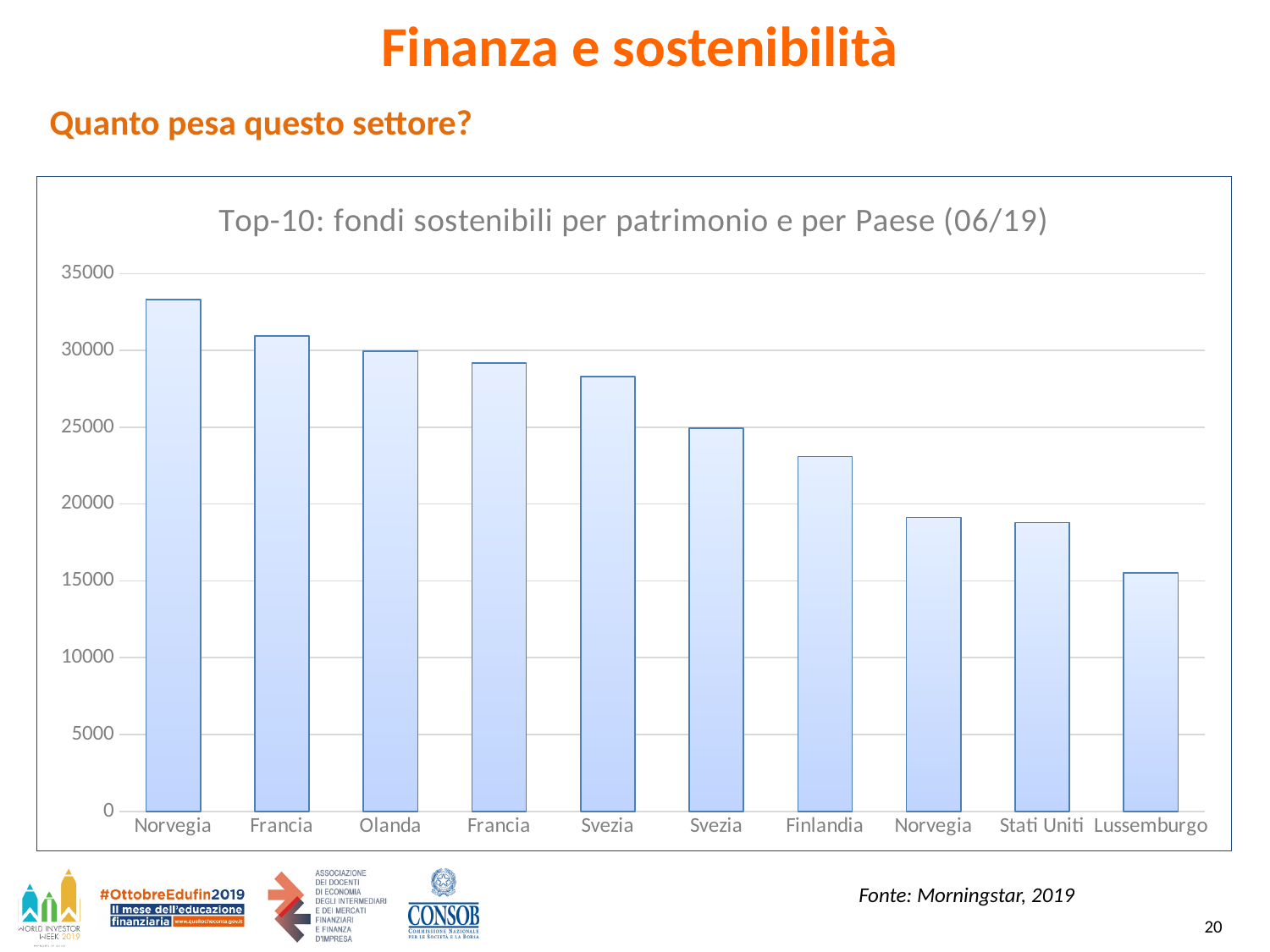
Do the bar values rise or fall from left to right along the x axis? Fall Is the value for Olanda greater or less than 25000? greater Which is larger, the value for Finlandia or the value for Stati Uniti? Finlandia Is the value for Lussemburgo greater or less than 20000? less What source is cited for the chart data? Morningstar, 2019 How many bars are plotted in the chart? 10 Is the value for Finlandia greater or less than 20000? greater What kind of chart is shown on the slide? Bar chart Which category has the lowest bar in the chart? Lussemburgo Which category label belongs to the highest bar in the chart? Norvegia (the leftmost bar) What is the title of the chart? Top-10: fondi sostenibili per patrimonio e per Paese (06/19)